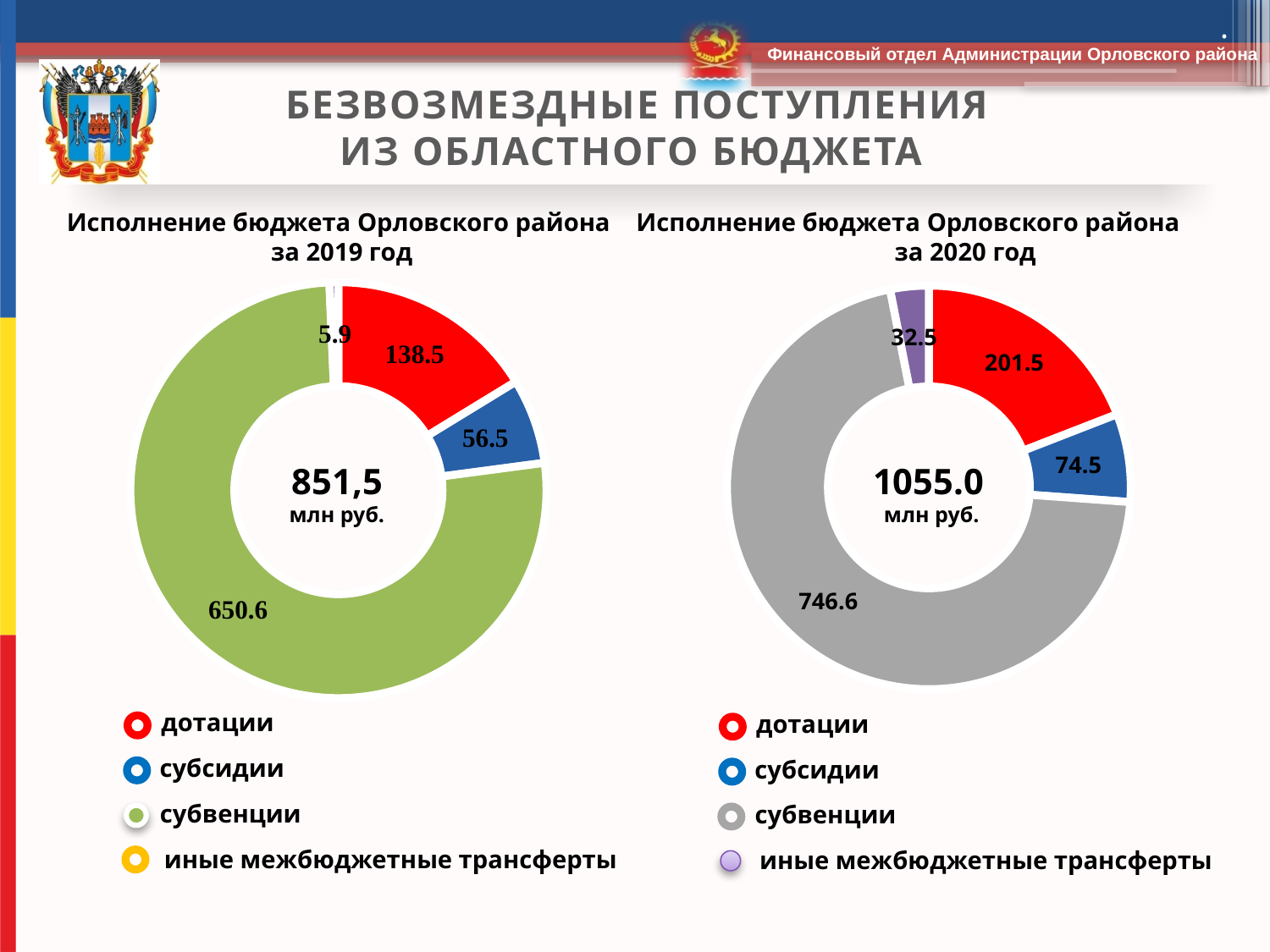
In the chart 'Исполнение бюджета Орловского района за 2020 год', what colour is the субвенции slice? Grey What total is shown in the centre of the chart 'Исполнение бюджета Орловского района за 2020 год'? 1055.0 млн руб. In the chart 'Исполнение бюджета Орловского района за 2020 год', what is the value for иные межбюджетные трансферты? 32.5 In the chart 'Исполнение бюджета Орловского района за 2020 год', what is the value for субсидии? 74.5 In the chart 'Исполнение бюджета Орловского района за 2019 год', which category has the smallest value? иные межбюджетные трансферты In the chart 'Исполнение бюджета Орловского района за 2019 год', what is the value for дотации? 138.5 How many categories does the legend of the chart 'Исполнение бюджета Орловского района за 2020 год' list? 4 In the chart 'Исполнение бюджета Орловского района за 2019 год', what is the value for субвенции? 650.6 In the chart 'Исполнение бюджета Орловского района за 2020 год', which category has the largest value? субвенции What type of chart is used on the slide for the 2019 and 2020 budget execution? Pie (donut) chart In the chart 'Исполнение бюджета Орловского района за 2019 год', which is larger: дотации or субсидии? дотации What is the difference between дотации in the 2020 chart and дотации in the 2019 chart? 63.0